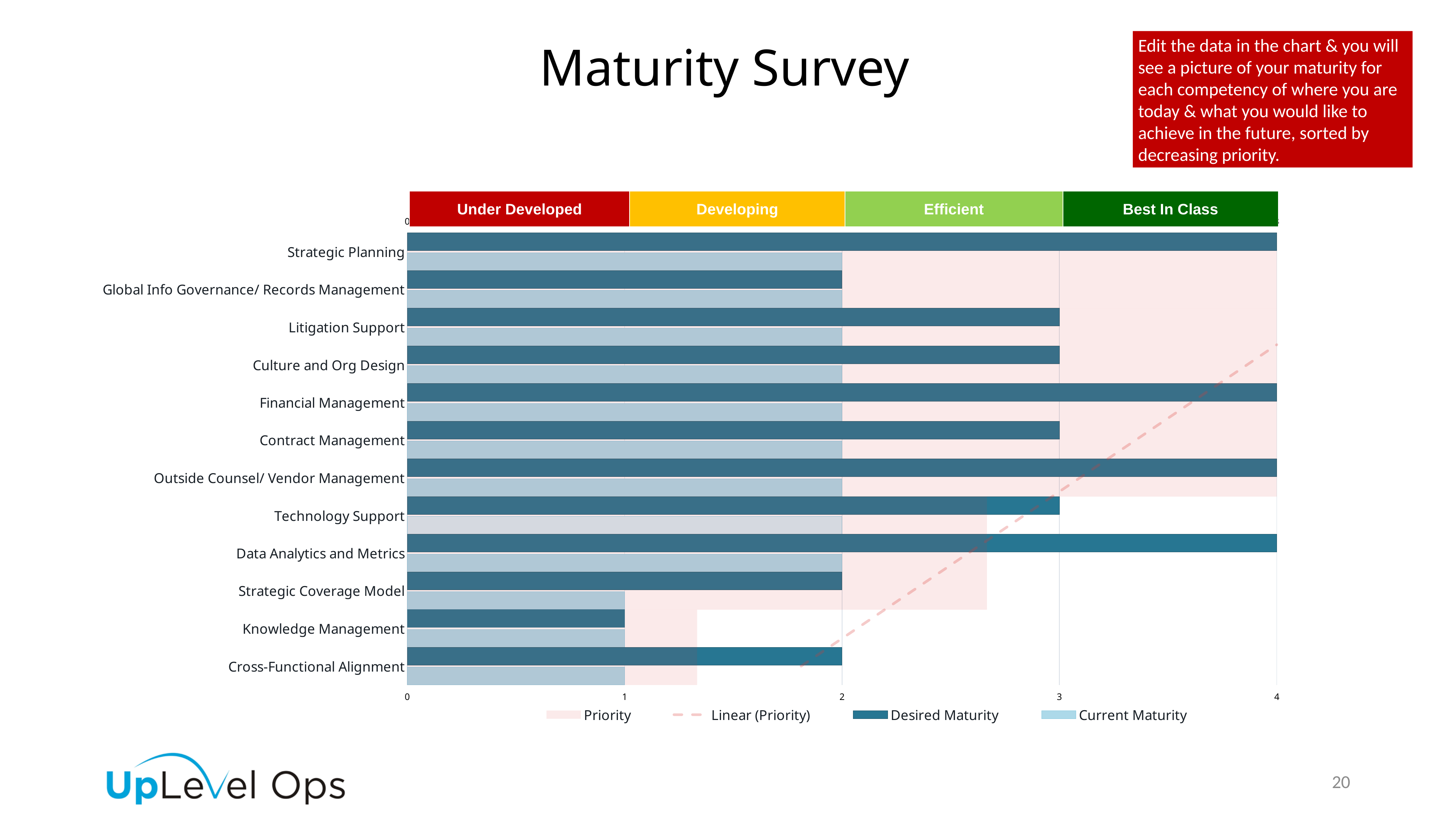
Which is larger, the Desired Maturity for Data Analytics and Metrics or the Desired Maturity for Strategic Coverage Model? Data Analytics and Metrics How many series does the chart legend list? 4 What are the four maturity levels labelled in the coloured band above the chart, from left to right? Under Developed, Developing, Efficient, Best In Class What is the difference between the Desired Maturity and Current Maturity values for Financial Management? 2 Is the Desired Maturity value for Cross-Functional Alignment greater or less than 3? less What is the Desired Maturity value for Litigation Support? 3 What kind of chart is shown on the slide? bar chart What is the Current Maturity value for Contract Management? 2 What is the Current Maturity value for Knowledge Management? 1 Which competency has the lowest Desired Maturity value? Knowledge Management How many competencies (categories) are listed on the chart? 12 What is the Desired Maturity value for Strategic Planning? 4